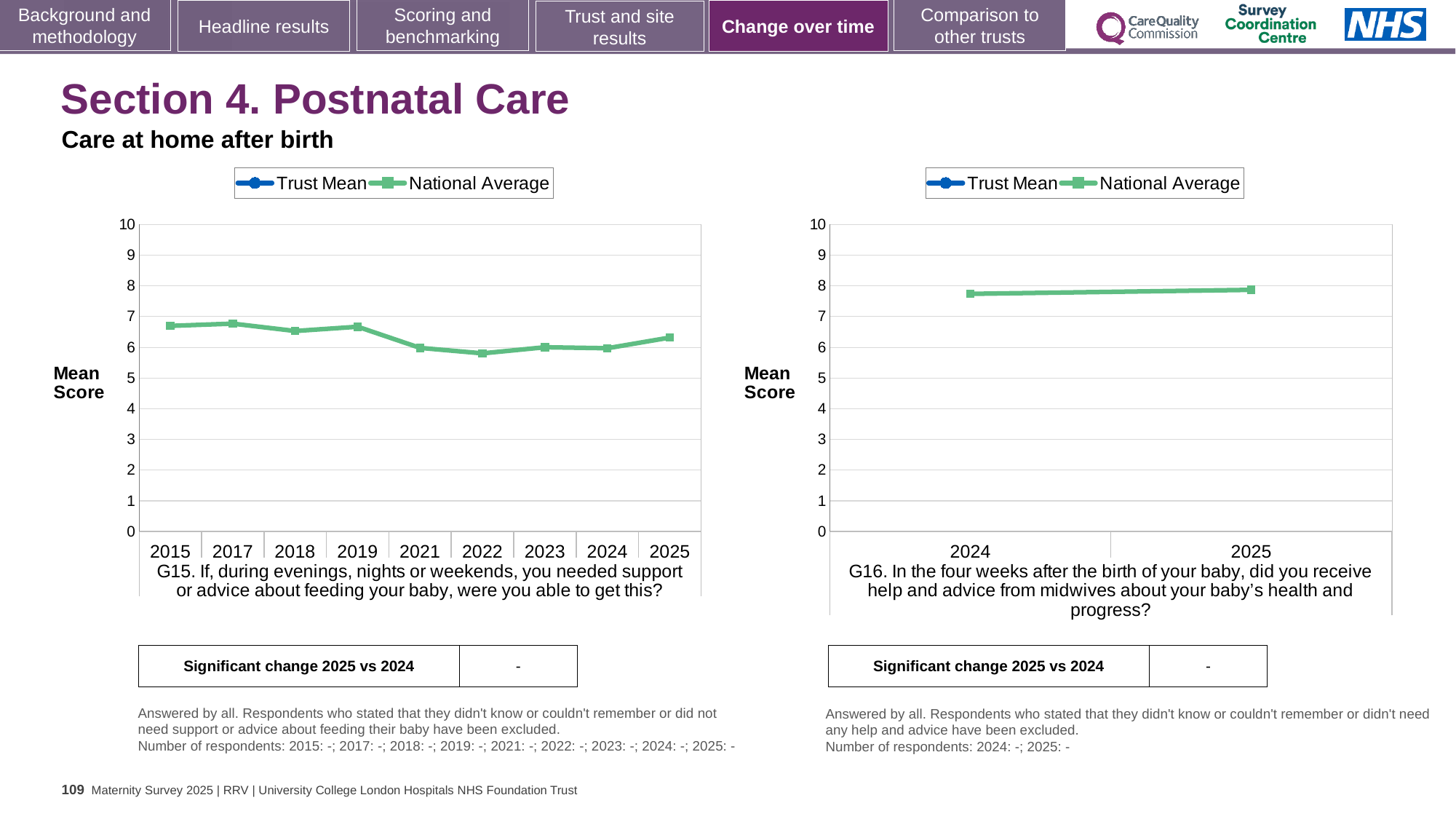
In the left chart (G15), is the National Average value for 2025 greater or less than 7? less In the right chart (G16), is the National Average value for 2025 greater or less than 7? greater What are the two legend entries shown for the right chart (G16)? Trust Mean, National Average In the left chart (G15), is the National Average value for 2015 larger or smaller than the value for 2022? larger How many series does the legend of the left chart (G15) list? 2 In the right chart (G16), is the National Average value for 2024 greater or less than 8? less How many years are shown on the x axis of the left chart (G15)? 9 In the left chart (G15), does the National Average line overall rise or fall from 2015 to 2025? fall How many years are shown on the x axis of the right chart (G16)? 2 What kind of chart is the left chart (G15)? line chart In the left chart (G15), which year has the lowest National Average value? 2022